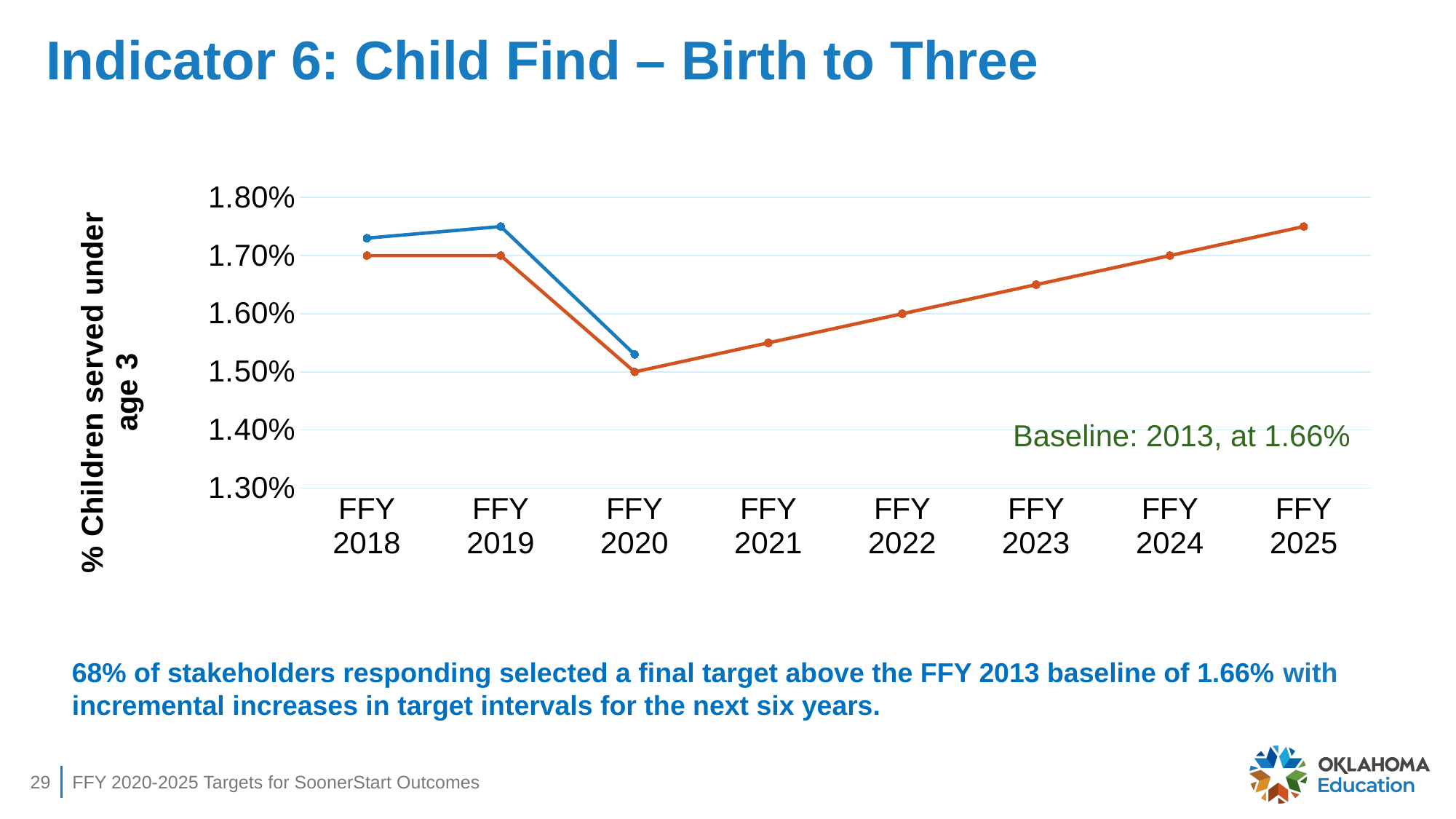
What is the value of the orange line at FFY 2024? 1.70% What is the value of the orange line at FFY 2020? 1.50% What is the value of the orange line at FFY 2018? 1.70% How many FFY categories are shown along the x axis? 8 At which FFY does the orange line reach its lowest value? FFY 2020 Is the value of the blue line at FFY 2019 greater or less than 1.70%? greater Is the value of the orange line at FFY 2025 greater or less than 1.80%? less What baseline value is noted on the chart? Baseline: 2013, at 1.66% What is the value of the orange line at FFY 2022? 1.60% What kind of chart is shown on the slide? line chart At FFY 2020, which line has the higher value, the blue line or the orange line? the blue line Does the orange line rise or fall from FFY 2020 to FFY 2025? rises